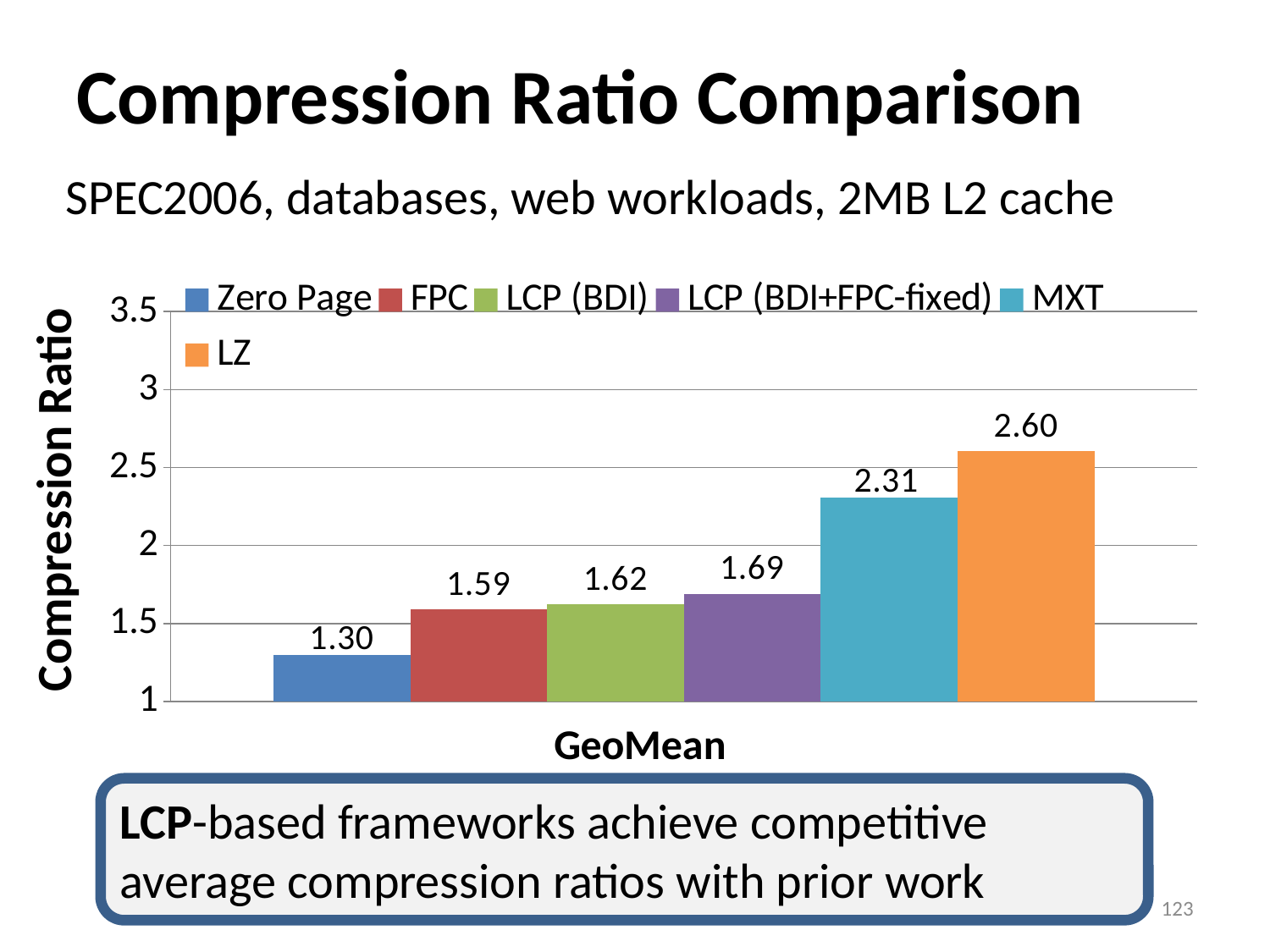
How many series does the legend list? 6 What is the compression ratio for LCP (BDI+FPC-fixed)? 1.69 Which has a higher compression ratio, MXT or LCP (BDI+FPC-fixed)? MXT What is the difference between the compression ratios of LZ and MXT? 0.29 Which series has the lowest compression ratio? Zero Page What is the label on the x axis of the chart? GeoMean What is the difference between the compression ratios of LCP (BDI) and FPC? 0.03 Is the compression ratio for LZ greater or less than 2.5? greater What is the compression ratio for Zero Page? 1.30 What is the compression ratio for MXT? 2.31 What kind of chart is shown on the slide? Bar chart Which series has the highest compression ratio? LZ